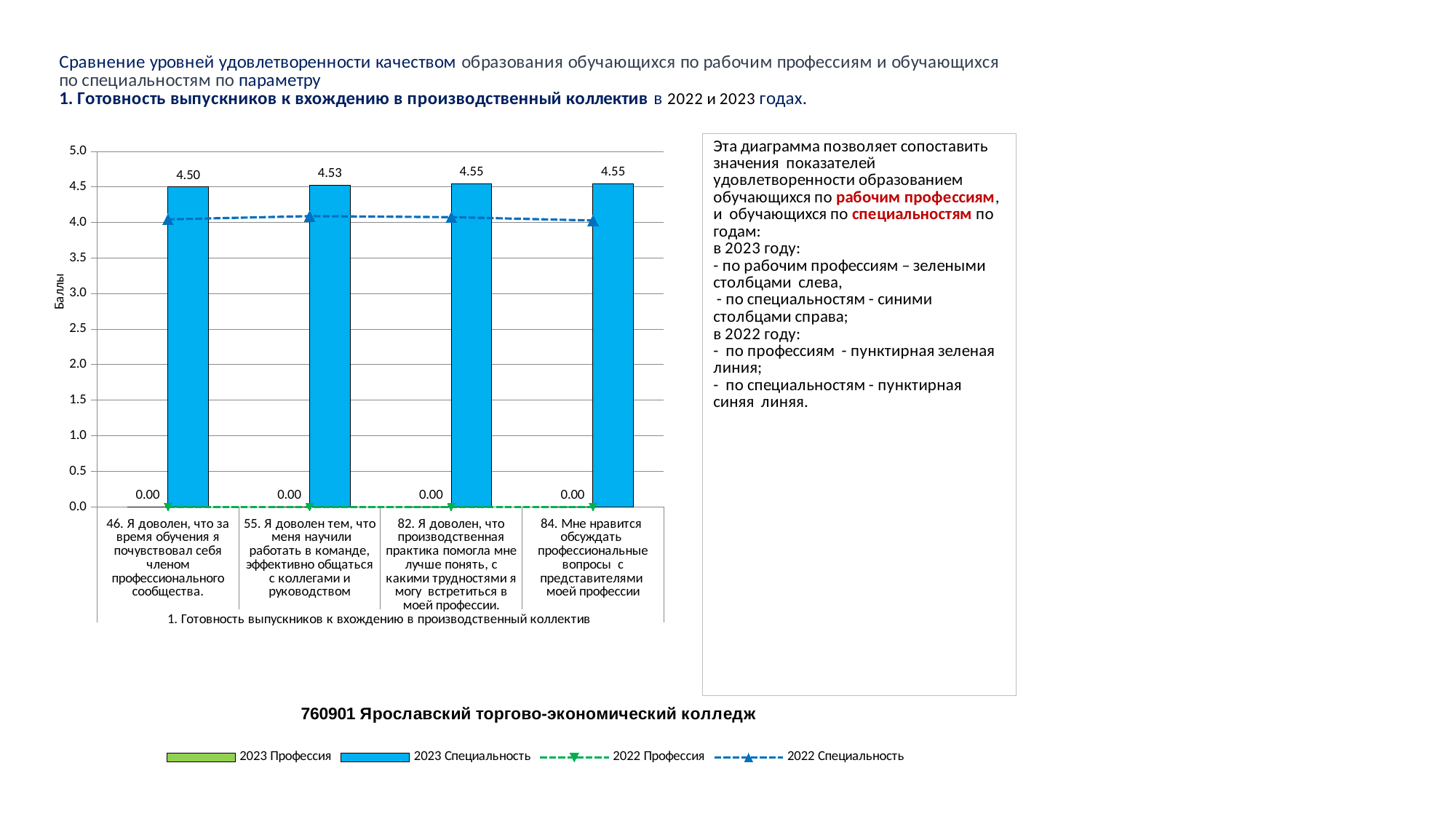
What is the value of the 2023 Специальность bar for category 82 (производственная практика помогла мне лучше понять)? 4.55 What is the value of the 2023 Профессия bar for category 84 (Мне нравится обсуждать профессиональные вопросы)? 0.00 How many series does the legend list? 4 What is the difference between the 2023 Специальность values for category 82 and category 46? 0.05 What kind of chart is shown on the slide? bar chart with line series Is the 2022 Специальность value for category 46 greater or less than 3.5? greater Which category has the lowest 2023 Специальность value? 46. Я доволен, что за время обучения я почувствовал себя членом профессионального сообщества. What is the value of the 2023 Специальность bar for category 55 (Я доволен тем, что меня научили работать в команде)? 4.53 What is the label of the y axis? Баллы Which is larger: the 2023 Специальность value for category 55 or for category 46? category 55 What is the value of the 2023 Специальность bar for category 46 (Я доволен, что за время обучения я почувствовал себя членом профессионального сообщества)? 4.50 How many categories are shown on the x axis? 4